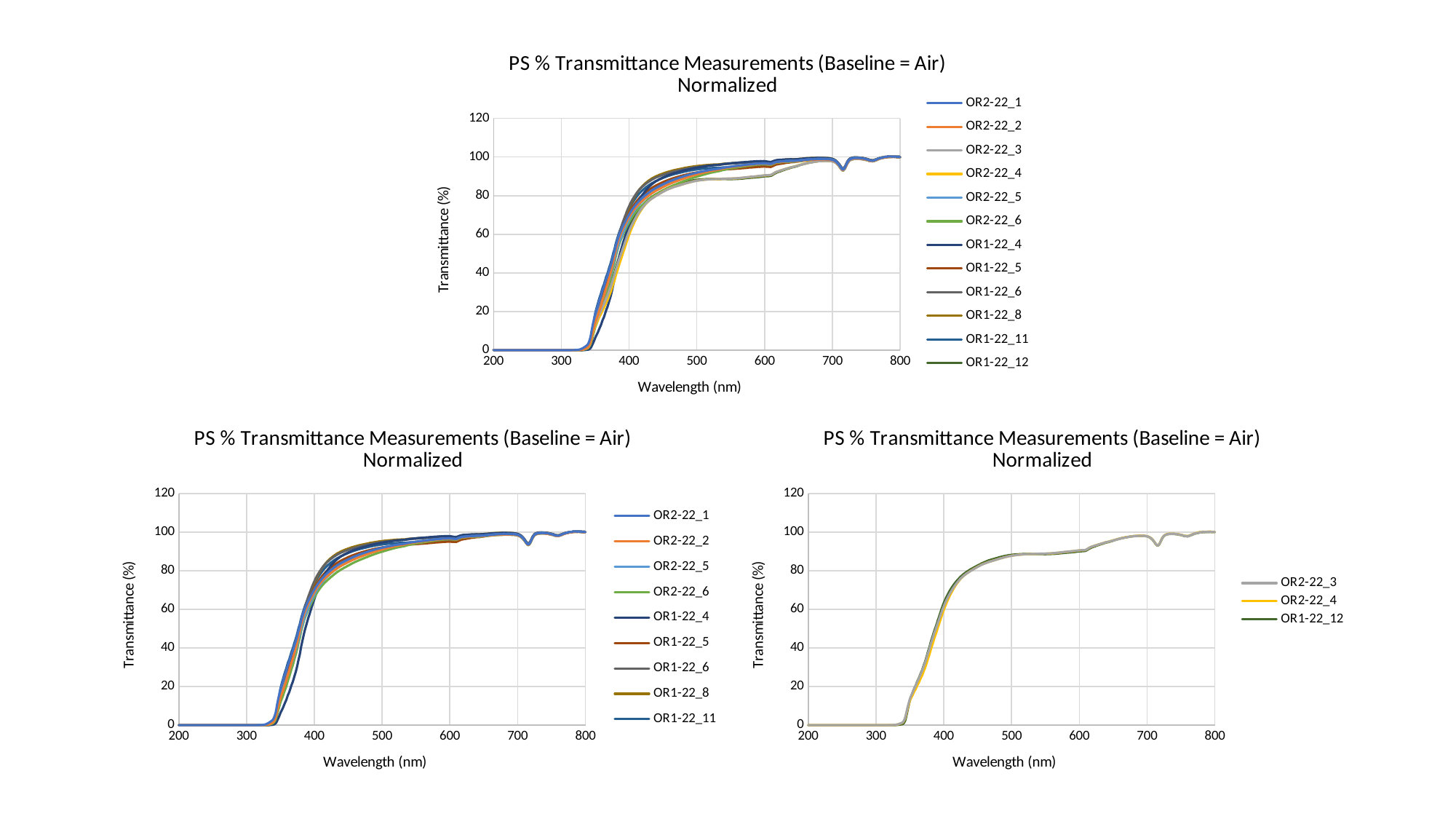
In the bottom-left chart, is the transmittance value for OR1-22_4 at 600 nm greater or less than 60? greater What kind of chart is the top chart? Line chart In the bottom-right chart, is the transmittance value for OR2-22_3 at 700 nm greater or less than 80? greater How many series does the legend of the bottom-left chart list? 9 How many series does the legend of the top chart list? 12 In the bottom-right chart, do the transmittance values rise or fall as wavelength increases from 300 nm to 800 nm? Rise What is the x-axis title of the bottom-left chart? Wavelength (nm) In the top chart, is the transmittance value for OR1-22_8 at 800 nm greater or less than 80? greater How many series does the legend of the bottom-right chart list? 3 Which series are listed in the legend of the bottom-right chart? OR2-22_3, OR2-22_4, OR1-22_12